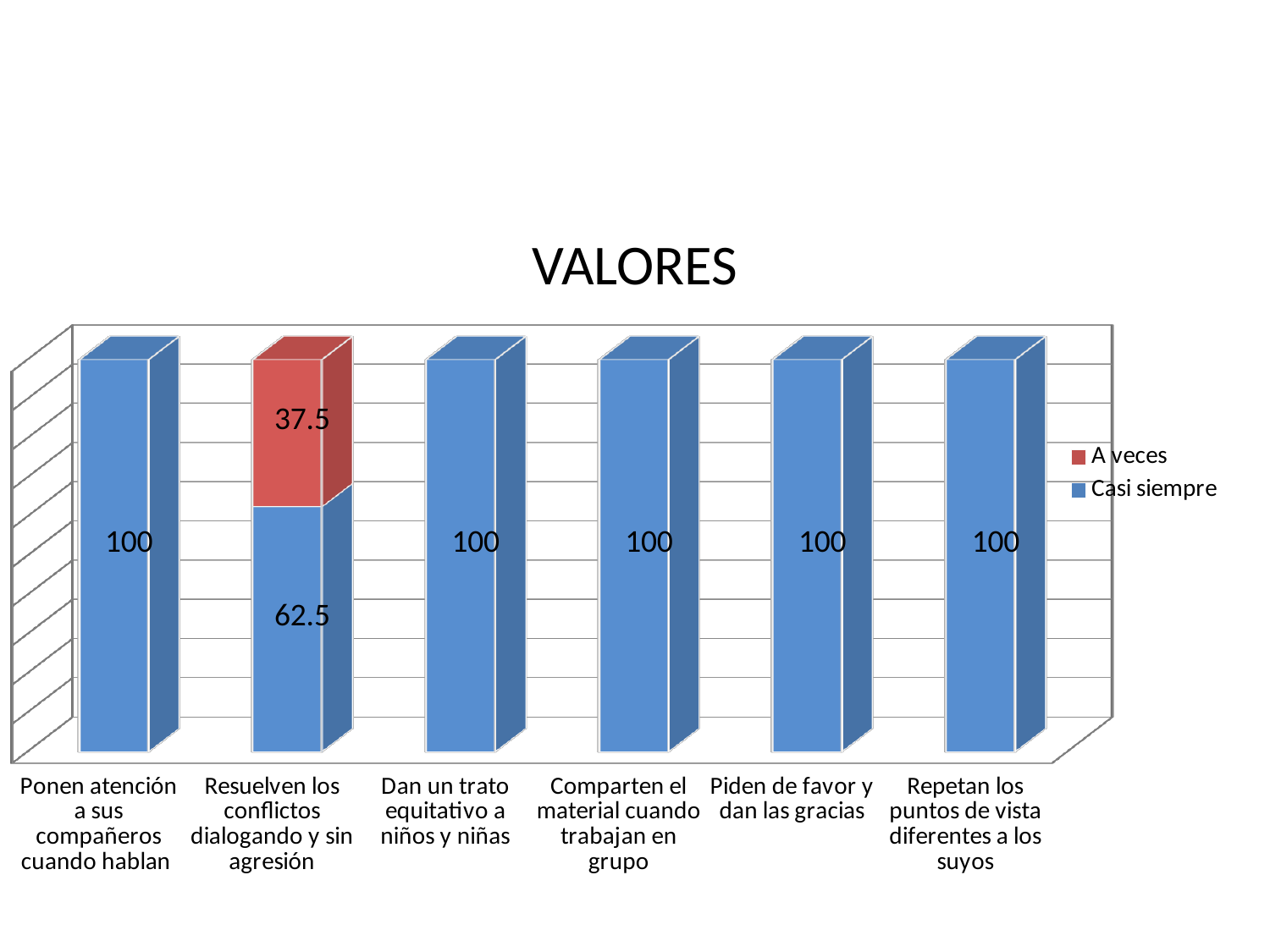
How many series does the legend list? 2 What kind of chart is shown on the slide? Stacked bar chart What is the 'Casi siempre' value for 'Comparten el material cuando trabajan en grupo'? 100 What is the total of the stacked bar for 'Resuelven los conflictos dialogando y sin agresión'? 100 What is the difference between the 'Casi siempre' and 'A veces' values for 'Resuelven los conflictos dialogando y sin agresión'? 25 Which series is shown in red in the legend? A veces What is the 'Casi siempre' value for 'Piden de favor y dan las gracias'? 100 Which category has the lowest 'Casi siempre' value? Resuelven los conflictos dialogando y sin agresión How many categories are shown on the x axis? 6 What is the 'Casi siempre' value for 'Resuelven los conflictos dialogando y sin agresión'? 62.5 What is the 'A veces' value for 'Resuelven los conflictos dialogando y sin agresión'? 37.5 What is the title of the chart? VALORES